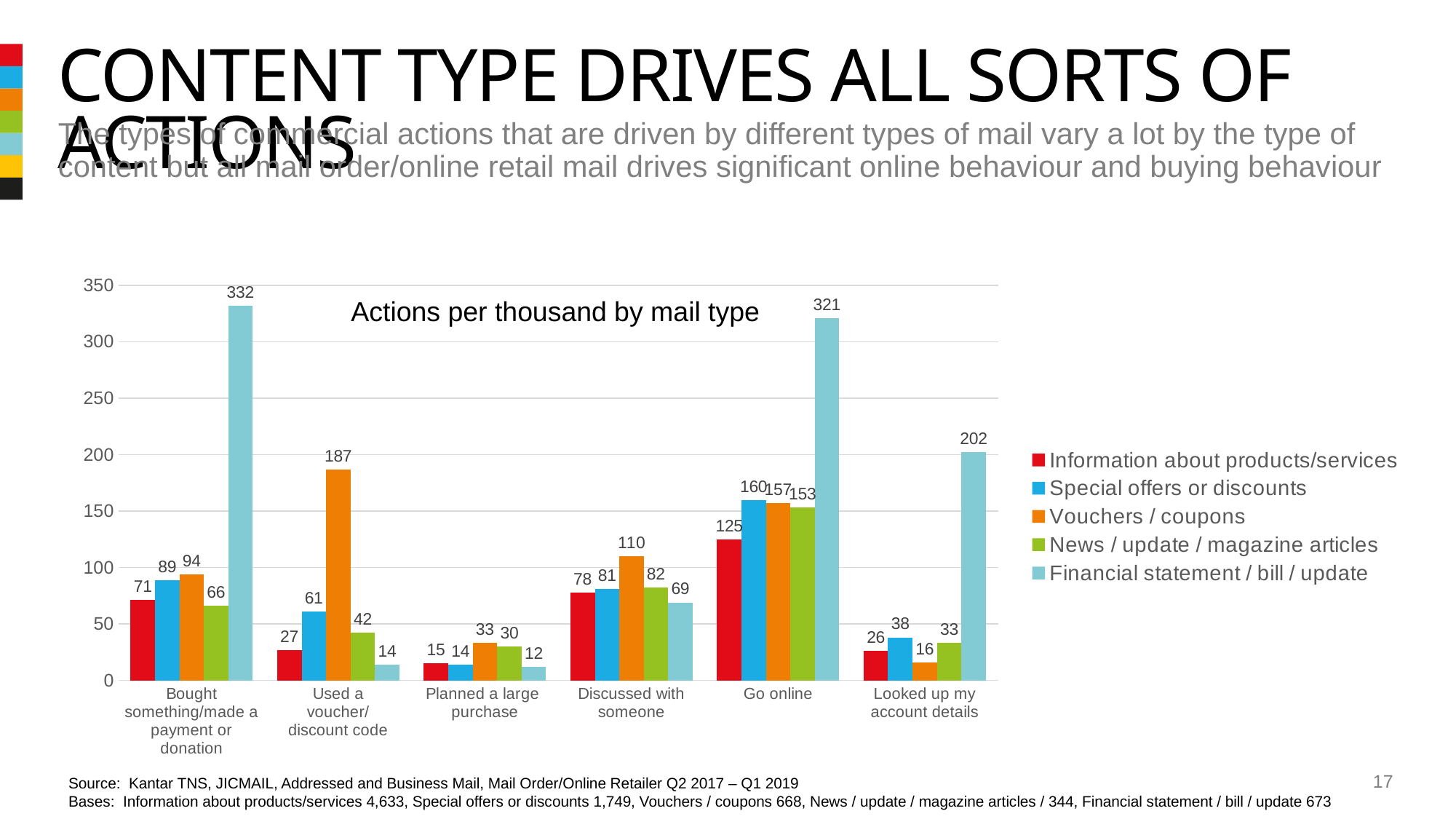
What is the value for Financial statement / bill / update in the 'Bought something/made a payment or donation' category? 332 Is the value for Vouchers / coupons in the 'Used a voucher/discount code' category greater or less than 150? greater What is the value for Special offers or discounts in the 'Go online' category? 160 In the 'Discussed with someone' category, which is larger: Vouchers / coupons or News / update / magazine articles? Vouchers / coupons What is the title of the chart? Actions per thousand by mail type What kind of chart is shown on the slide? Bar chart What is the value for Vouchers / coupons in the 'Used a voucher/discount code' category? 187 Which series has the highest value in the 'Looked up my account details' category? Financial statement / bill / update How many series does the legend list? 5 What is the difference between the Financial statement / bill / update value and the Information about products/services value in the 'Go online' category? 196 Which series has the lowest value in the 'Planned a large purchase' category? Financial statement / bill / update How many action categories are shown on the x axis? 6